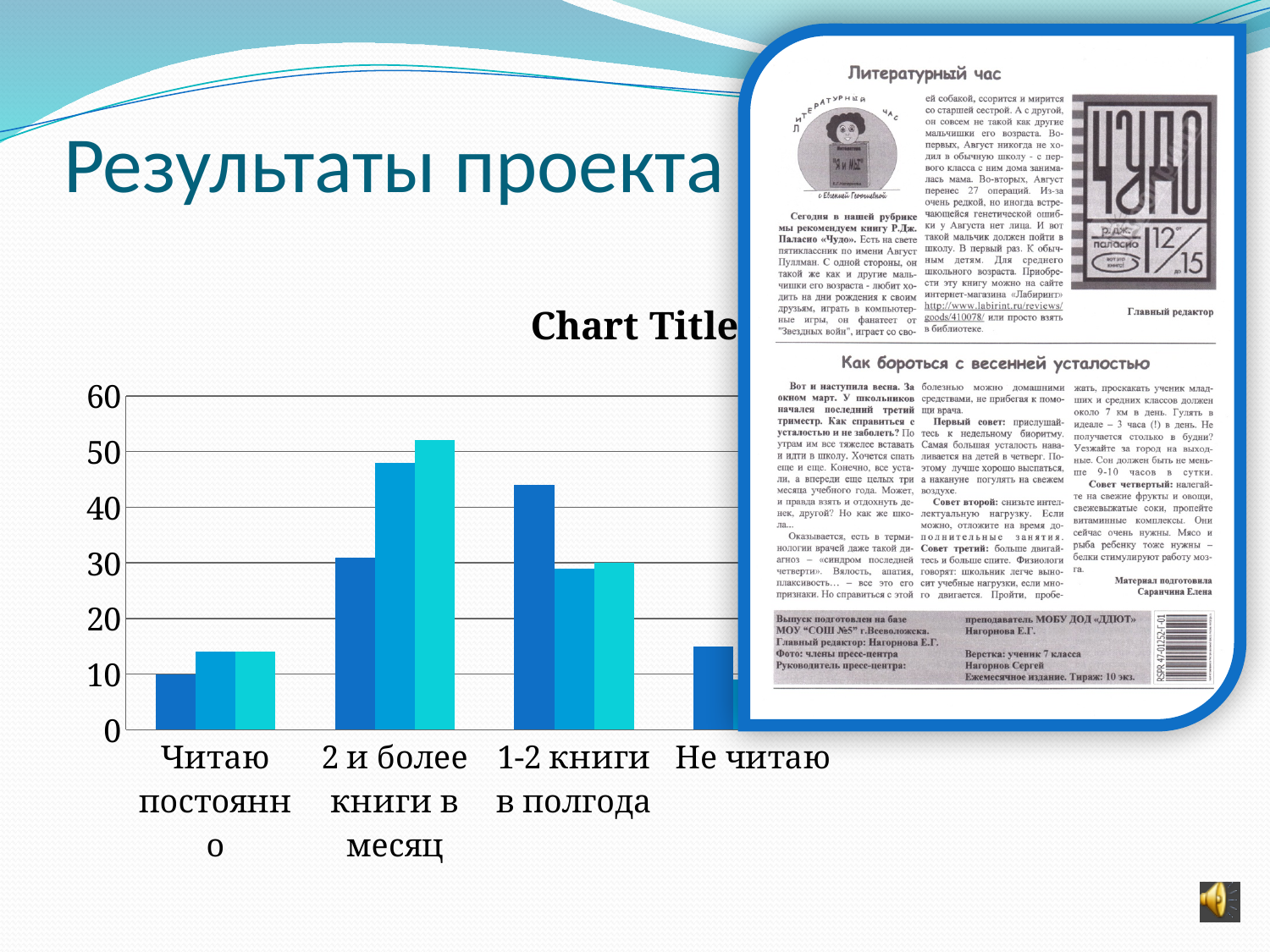
Is the tallest bar in the category "2 и более книги в месяц" greater or less than 50? greater Which category has the larger dark blue bar: "2 и более книги в месяц" or "1-2 книги в полгода"? 1-2 книги в полгода Which category contains the tallest bar in the chart? 2 и более книги в месяц Is the dark blue bar for "1-2 книги в полгода" greater or less than 40? greater Is the light blue bar for "Читаю постоянно" greater or less than 20? less How many categories are shown on the x axis of the chart? 4 What is the title of the chart? Chart Title What is the highest value shown on the vertical axis of the chart? 60 What kind of chart is shown on the slide? bar chart